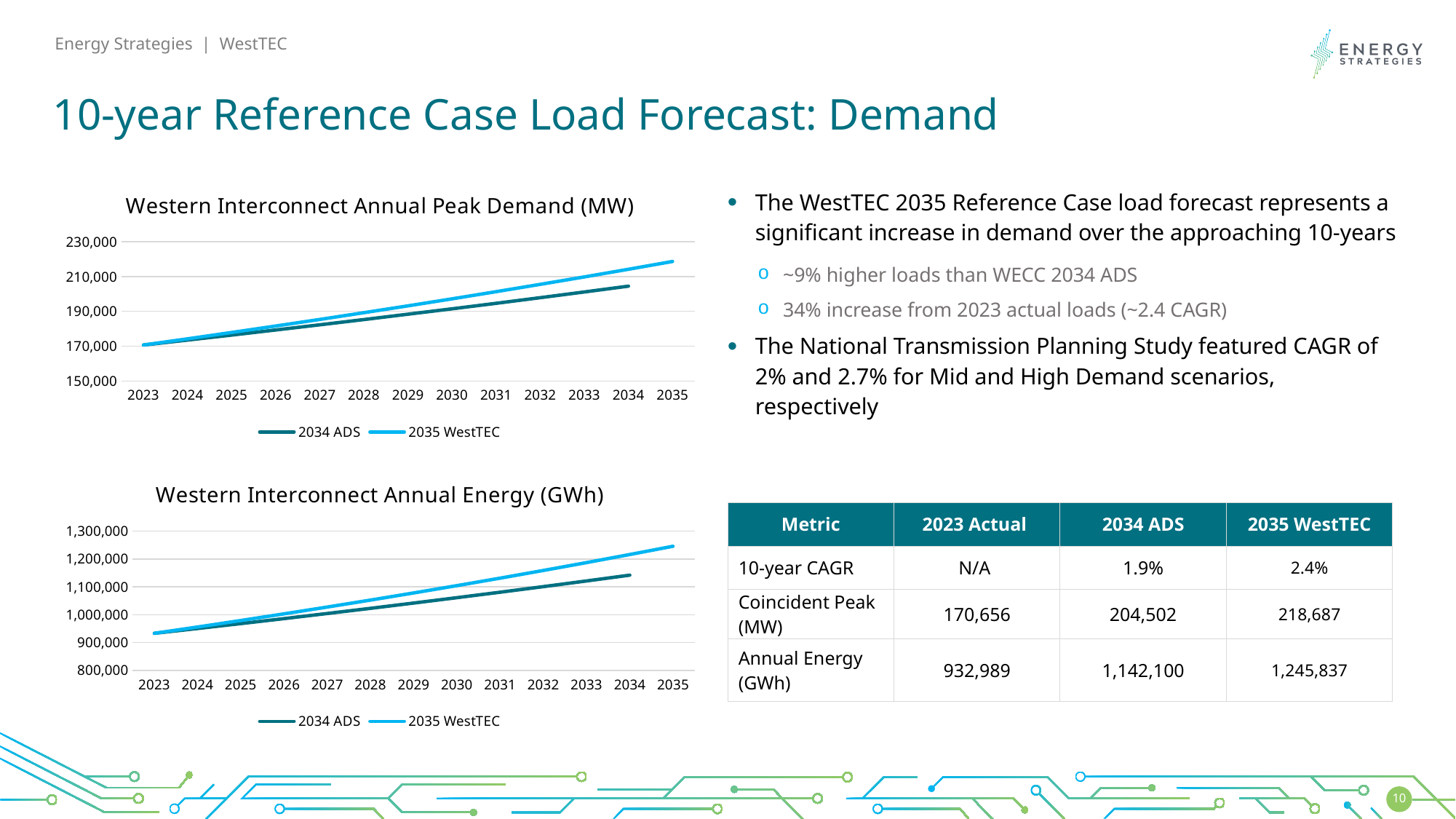
What are the two legend entries in the Western Interconnect Annual Peak Demand (MW) chart? 2034 ADS and 2035 WestTEC How many series does the legend of the Western Interconnect Annual Energy (GWh) chart list? 2 In the Western Interconnect Annual Peak Demand (MW) chart, is the 2034 ADS value in 2034 greater or less than 210,000? less In the Western Interconnect Annual Energy (GWh) chart, is the value in 2023 greater or less than 1,000,000? less In the Western Interconnect Annual Peak Demand (MW) chart, do the values rise or fall from 2023 to 2035? rise In the Western Interconnect Annual Energy (GWh) chart, which series is higher in 2034: 2034 ADS or 2035 WestTEC? 2035 WestTEC In the Western Interconnect Annual Energy (GWh) chart, is the 2034 ADS value in 2034 greater or less than 1,200,000? less What is the title of the lower chart on the slide? Western Interconnect Annual Energy (GWh) What type of chart is the Western Interconnect Annual Peak Demand (MW) chart? line chart In the Western Interconnect Annual Peak Demand (MW) chart, how many years are shown on the x axis? 13